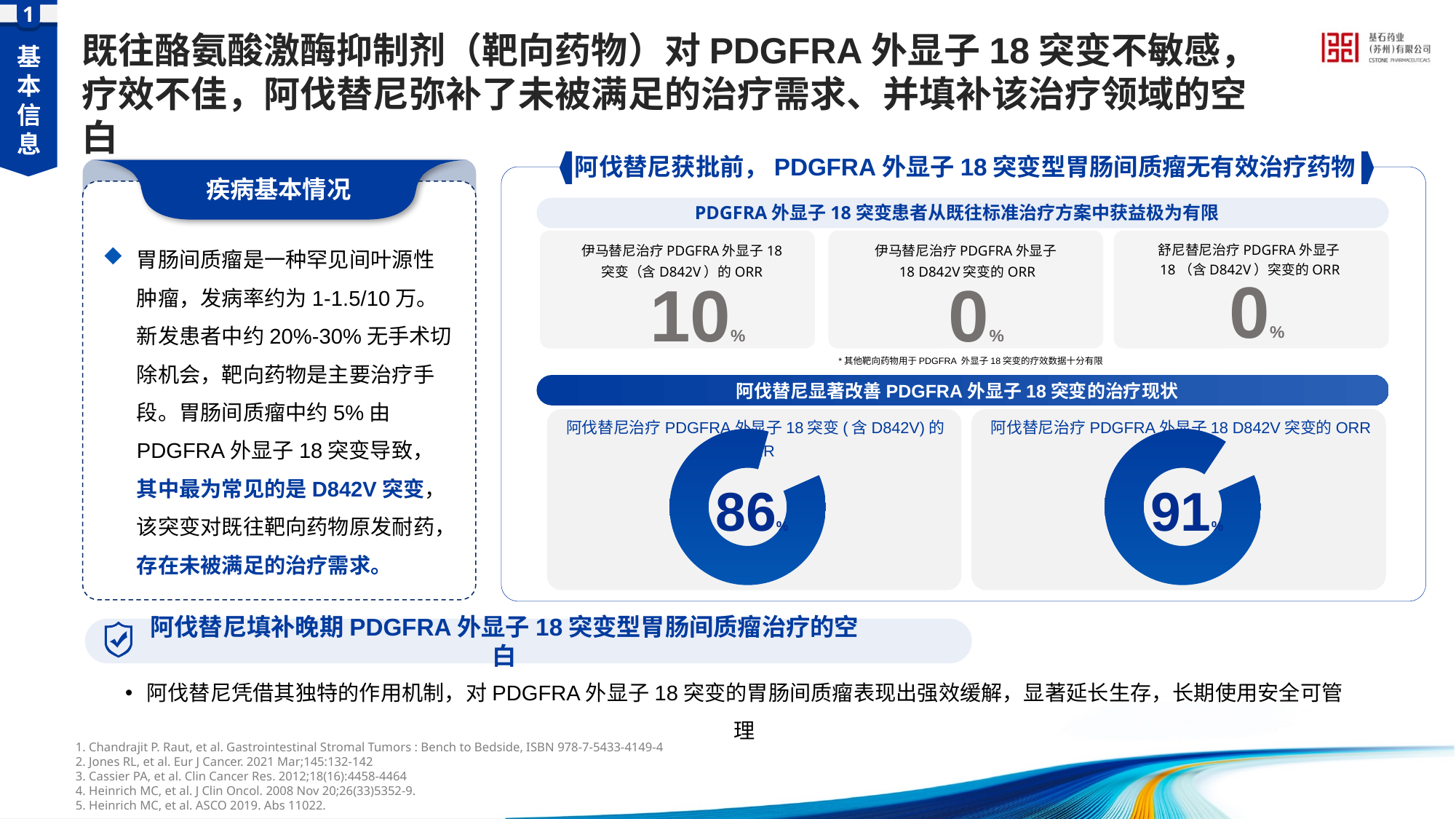
Which of the two doughnut charts shows the higher ORR value, the left one (含 D842V) or the right one (D842V 突变)? the right one (D842V 突变), 91% What is the difference between the ORR shown on the right doughnut chart (91%) and the ORR shown on the left doughnut chart (86%)? 5% Is the ORR value on the right doughnut chart (D842V 突变) greater or less than 90%? greater On the right doughnut chart (阿伐替尼治疗 PDGFRA 外显子 18 D842V 突变的 ORR), what value is shown in the centre? 91% What colour is the filled portion of the doughnut charts? blue On the left doughnut chart (阿伐替尼治疗 PDGFRA 外显子 18 突变 (含 D842V) 的 ORR), what value is shown in the centre? 86% What is the title of the section header above the two doughnut charts? 阿伐替尼显著改善 PDGFRA 外显子 18 突变的治疗现状 How many doughnut charts are shown on the slide? 2 What kind of chart is used to display the 86% and 91% ORR values? doughnut chart Is the ORR value on the left doughnut chart (含 D842V) greater or less than 80%? greater